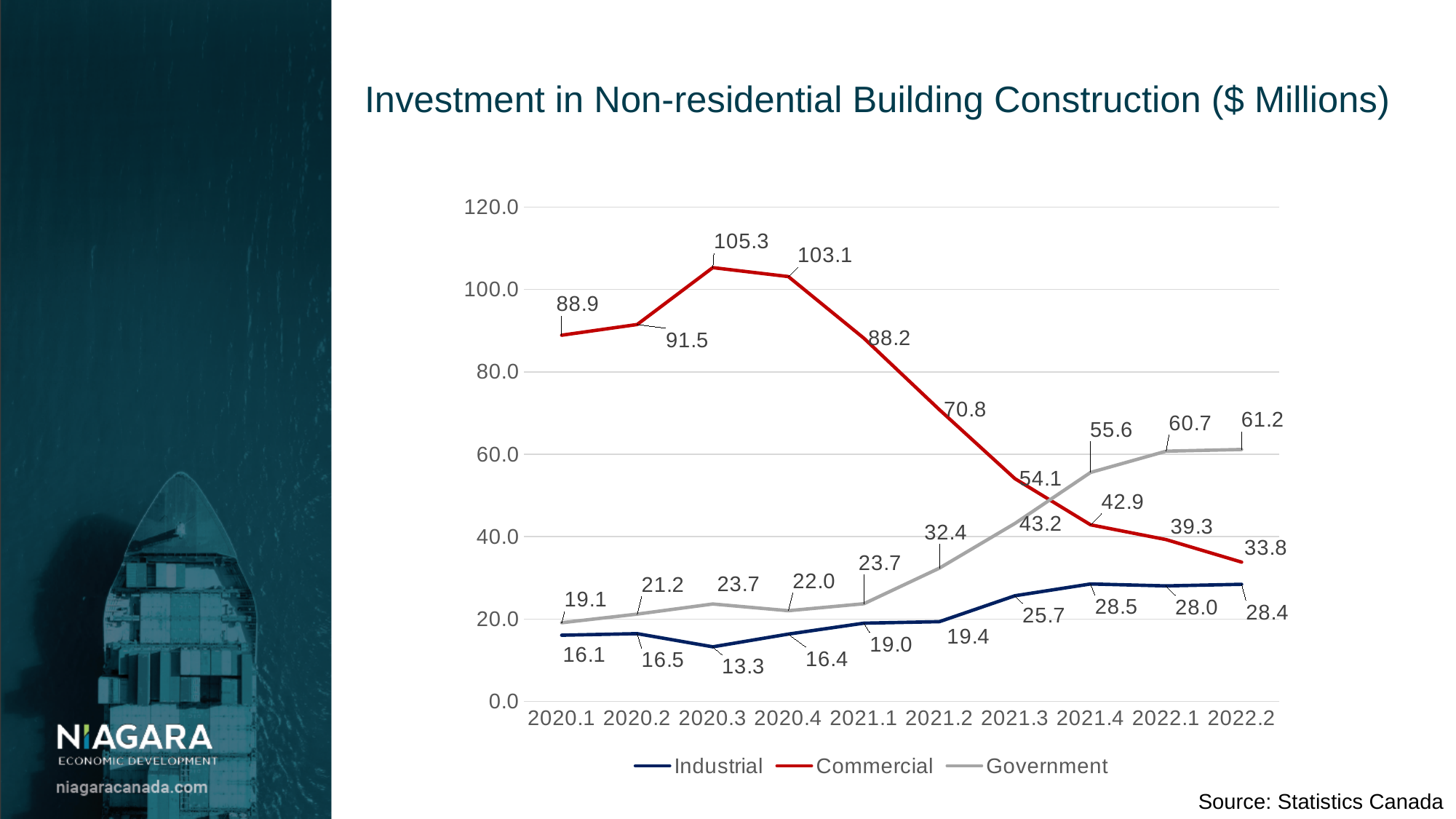
How many quarters are shown on the x axis? 10 What is the Government value for 2022.2? 61.2 In which quarter does the Commercial series reach its highest value? 2020.3 What is the difference between the Commercial value in 2020.3 and in 2022.2? 71.5 By how much did the Government value increase from 2020.1 to 2022.2? 42.1 In which quarter does the Industrial series reach its lowest value? 2020.3 In 2021.4, which is larger: the Government value or the Commercial value? Government What kind of chart is shown on the slide? Line chart How many series does the legend list? 3 What is the Industrial value for 2020.3? 13.3 Does the Commercial series rise or fall from 2020.3 to 2022.2? Fall What is the Commercial value for 2020.3? 105.3